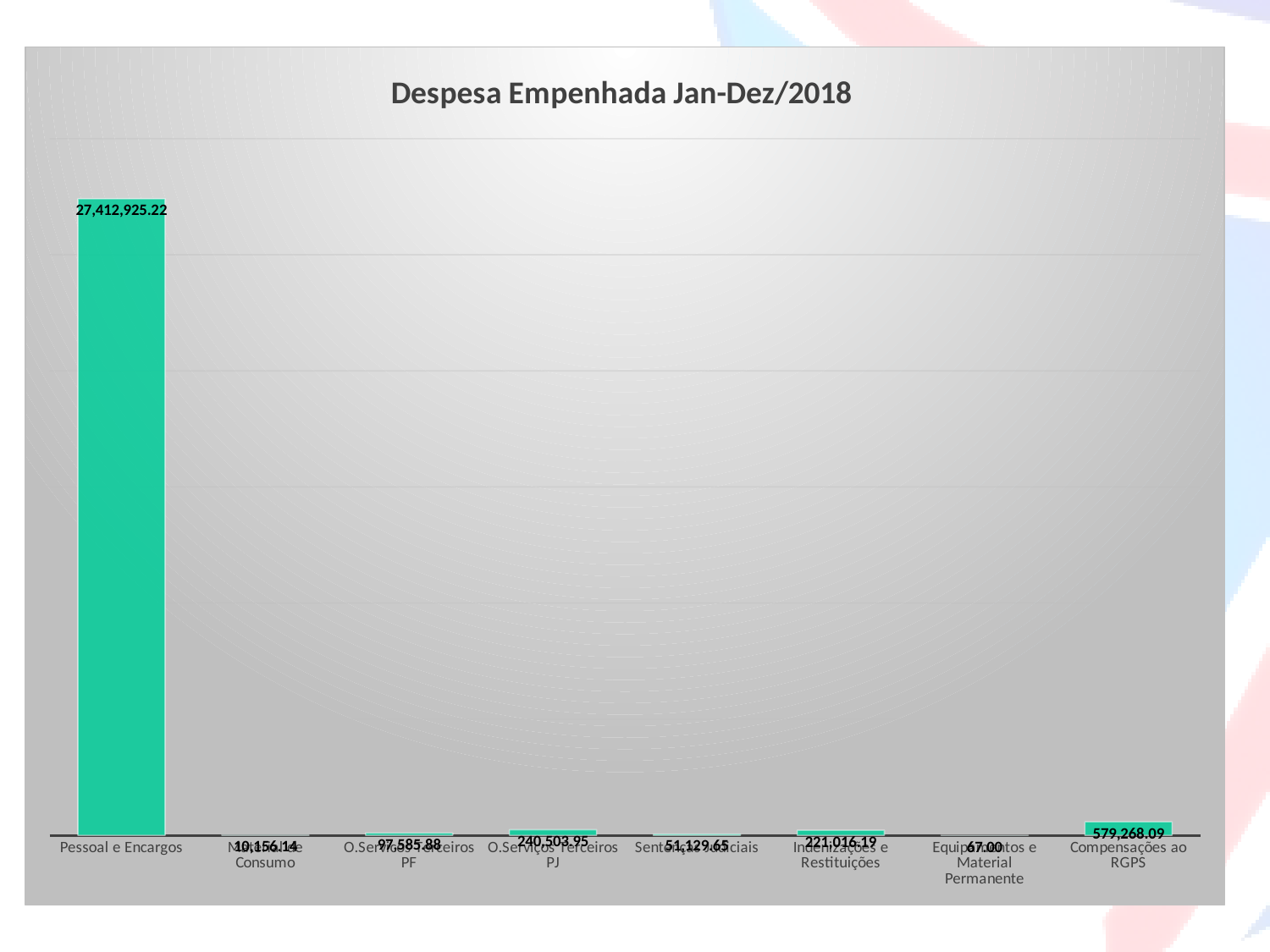
Which is larger, the value for Compensações ao RGPS or the value for O.Serviços Terceiros PJ? Compensações ao RGPS What is the difference between the value for Compensações ao RGPS and the value for O.Serviços Terceiros PJ? 338,764.14 Which category has the highest value? Pessoal e Encargos What is the title of the chart? Despesa Empenhada Jan-Dez/2018 How many categories are plotted in the chart? 8 What is the value for Indenizações e Restituições? 221,016.19 What is the value for Compensações ao RGPS? 579,268.09 What is the value for O.Serviços Terceiros PJ? 240,503.95 What is the value for Pessoal e Encargos? 27,412,925.22 What kind of chart is shown on the slide? Bar chart Which category has the lowest value? Equipamentos e Material Permanente What is the value for Sentenças Judiciais? 51,129.65